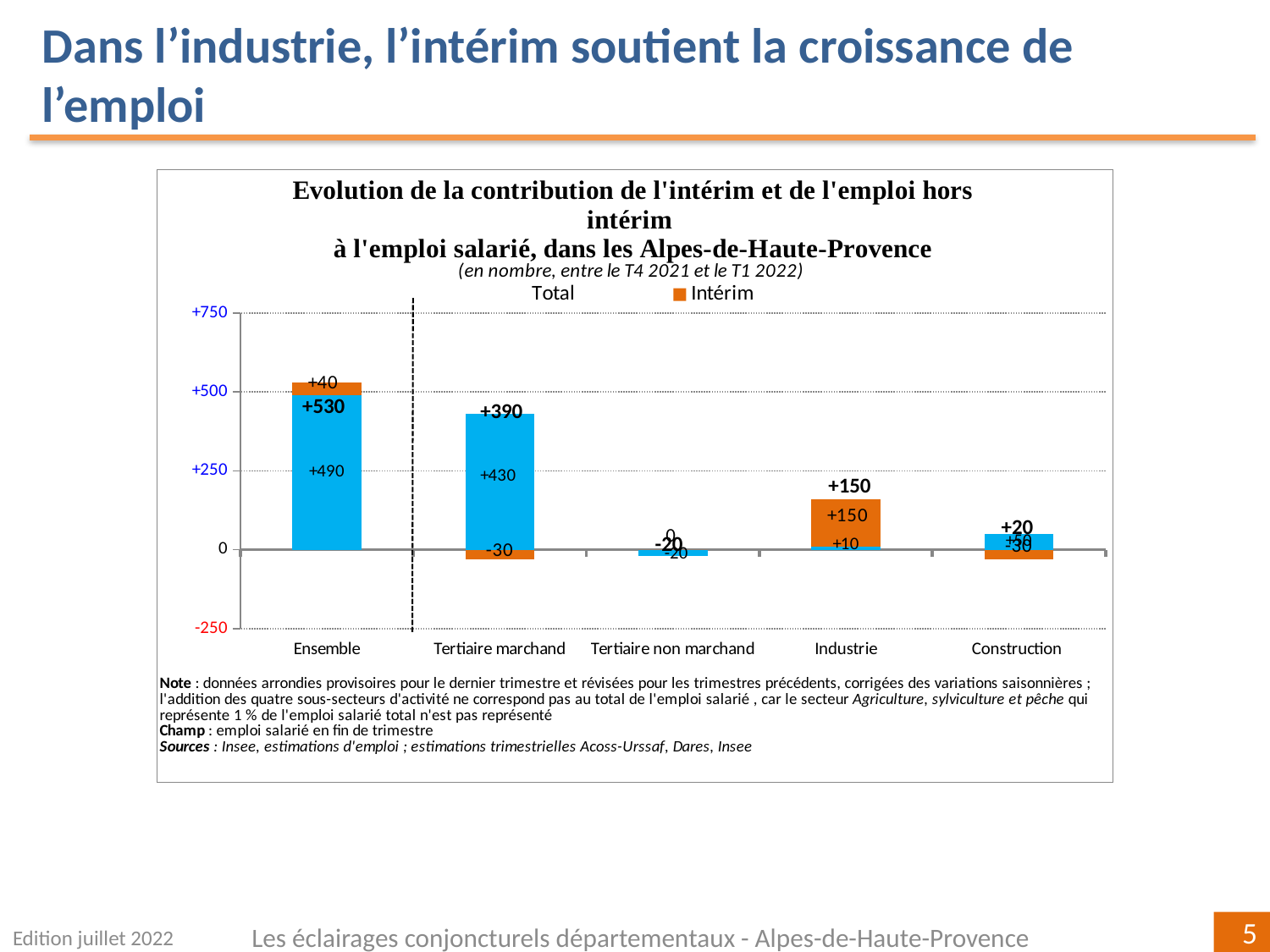
What is the Intérim value for Ensemble? +40 Which category has the highest Intérim value? Industrie What is the Intérim value for Tertiaire marchand? -30 How many categories are shown on the x axis? 5 What is the overall total printed above the Tertiaire marchand bar? +390 What is the Intérim value for Industrie? +150 What is the overall total printed above the Ensemble bar? +530 What kind of chart is this? Bar chart How many series does the legend list? 2